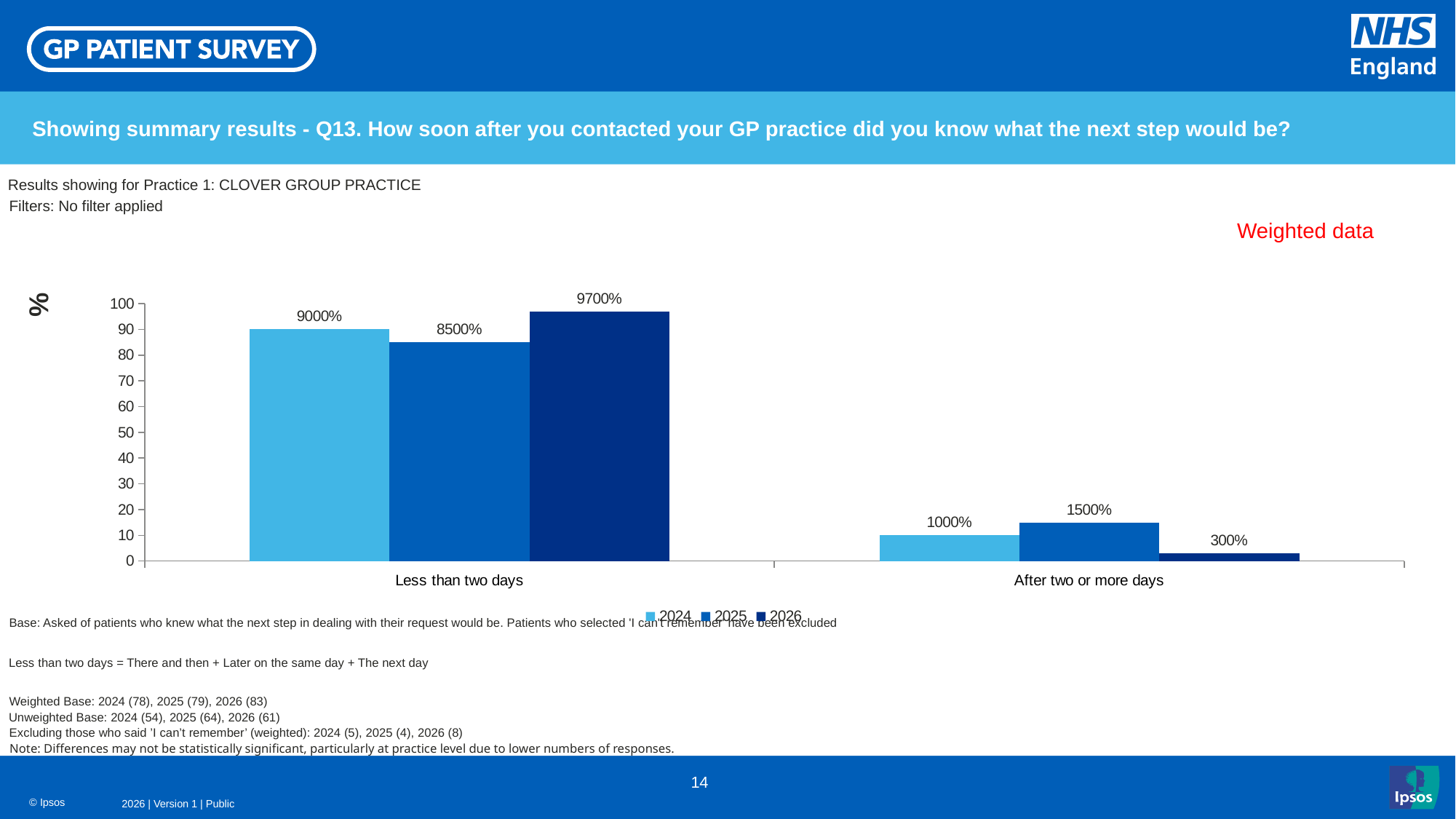
How many series does the legend list? 3 Is the 2026 bar for 'Less than two days' greater or less than 90 on the axis? greater What is the data label for 2024 in the 'After two or more days' category? 1000% Which year has the lowest bar in the 'After two or more days' category? 2026 How many categories are shown on the x axis? 2 What is the data label for 2026 in the 'Less than two days' category? 9700% What is the data label for 2025 in the 'Less than two days' category? 8500% What kind of chart is shown on the slide? Bar chart In the 'After two or more days' category, which is larger: the 2024 bar or the 2025 bar? 2025 What is the data label for 2024 in the 'Less than two days' category? 9000% Which year has the highest bar in the 'Less than two days' category? 2026 What is the data label for 2026 in the 'After two or more days' category? 300%